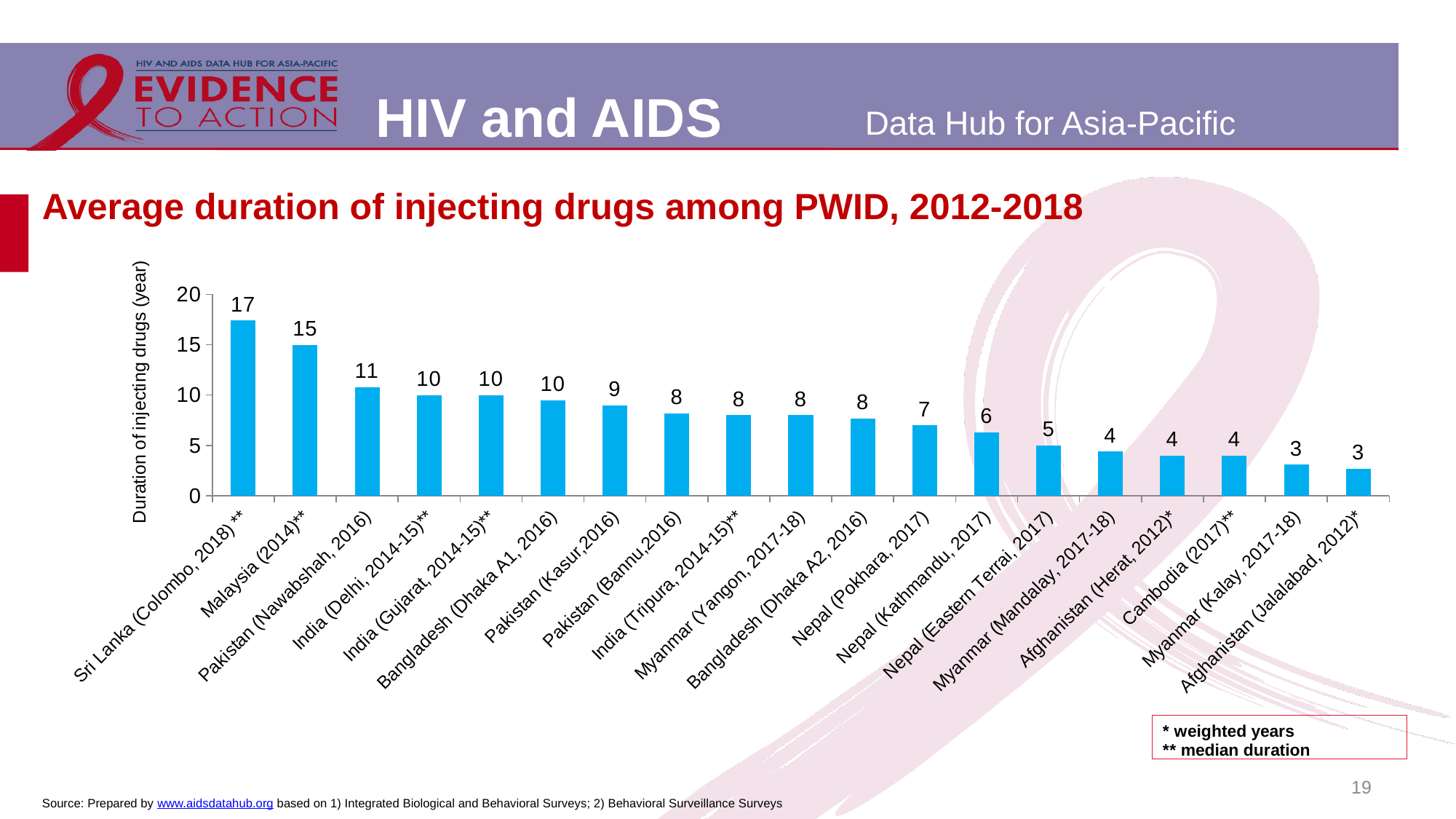
Which is larger, the value for Pakistan (Kasur, 2016) or the value for Nepal (Eastern Terrai, 2017)? Pakistan (Kasur, 2016) What is the value shown for Nepal (Kathmandu, 2017)? 6 Which category has the highest average duration of injecting drugs? Sri Lanka (Colombo, 2018) What is the difference between the values for Sri Lanka (Colombo, 2018) and Malaysia (2014)? 2 How many categories are plotted on the chart? 19 What is the average duration of injecting drugs for Sri Lanka (Colombo, 2018)? 17 What is the value shown for Malaysia (2014)? 15 What is the value shown for Pakistan (Nawabshah, 2016)? 11 What is the difference between the values for Pakistan (Nawabshah, 2016) and Nepal (Pokhara, 2017)? 4 What kind of chart is shown on the slide? bar chart What is the label of the vertical axis? Duration of injecting drugs (year) Is the value for Malaysia (2014) greater or less than 10? greater